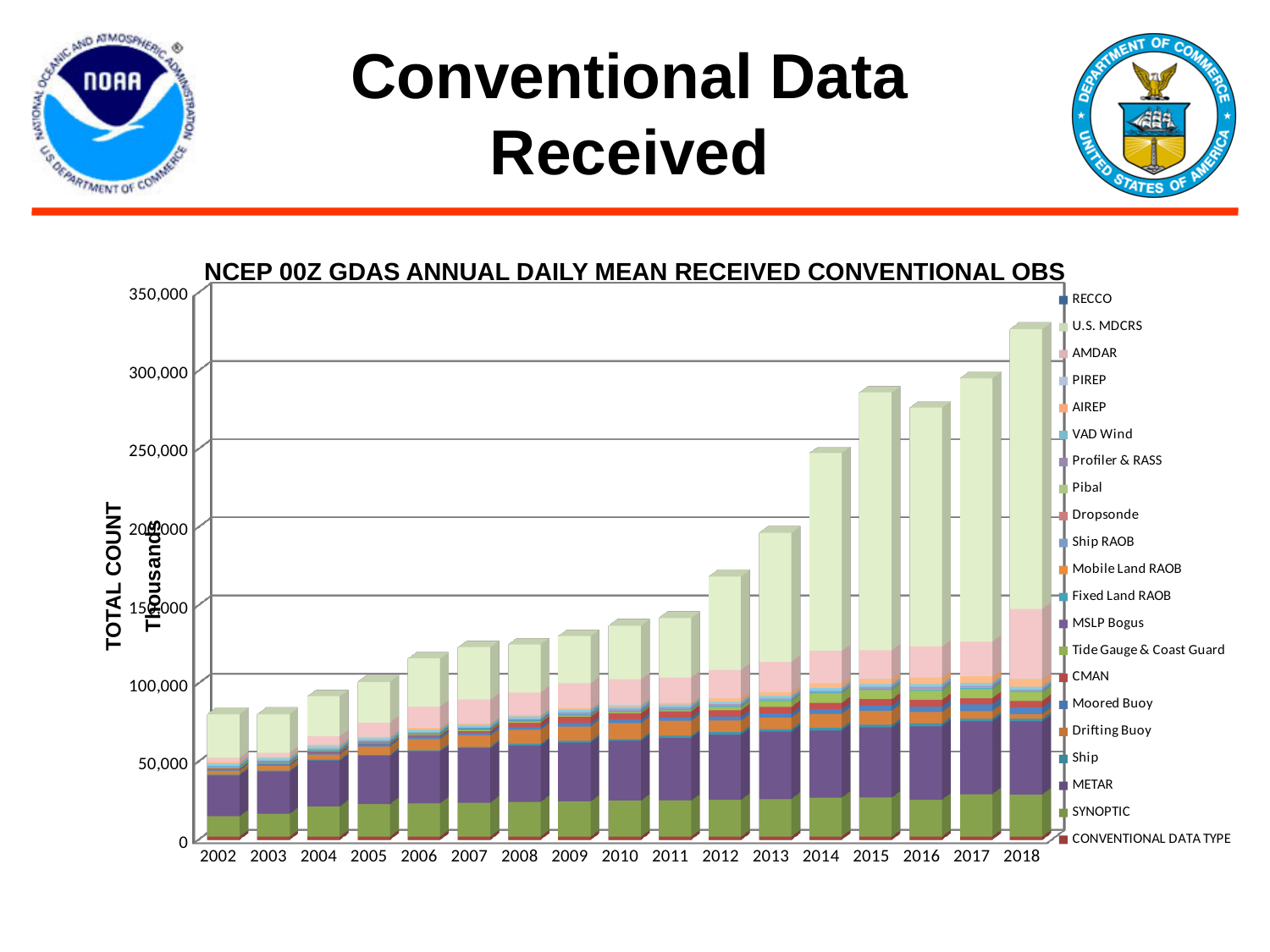
How many years are shown along the x axis of the chart? 17 Which year has the larger total bar, 2013 or 2014? 2014 Is the total for 2012 greater or less than 150,000? greater What kind of chart is shown on the slide? Stacked bar chart Is the total for 2010 greater or less than 100,000? greater Is the total for 2002 greater or less than 100,000? less Which year has the highest total bar in the chart? 2018 What is the first entry listed at the top of the chart's legend? RECCO Do the total bar heights generally rise or fall from 2002 to 2018? rise What is the title of the chart? NCEP 00Z GDAS ANNUAL DAILY MEAN RECEIVED CONVENTIONAL OBS